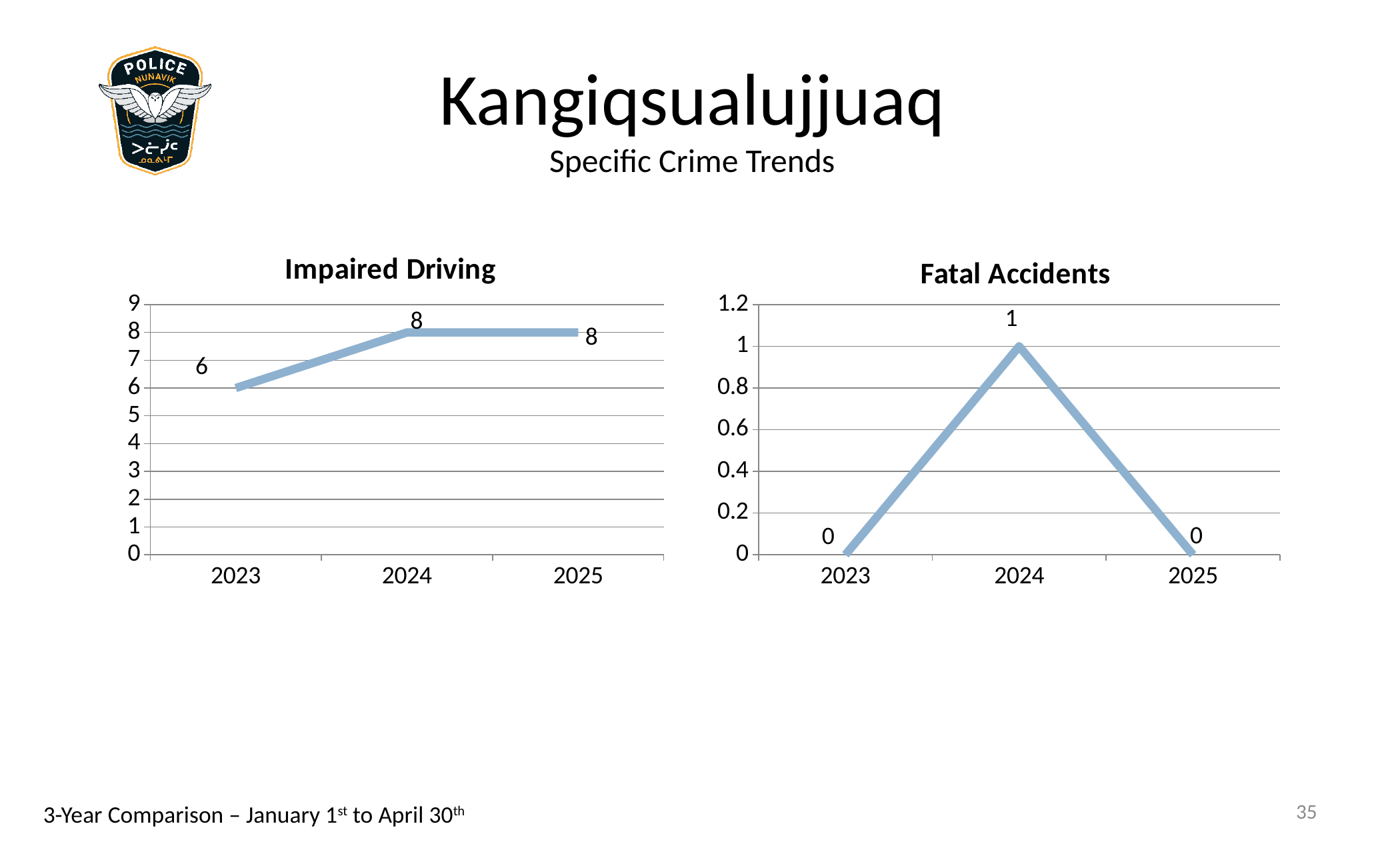
In the Impaired Driving chart, what is the value for 2025? 8 In the Impaired Driving chart, do the values rise or fall from 2023 to 2024? rise In the Fatal Accidents chart, what is the value for 2025? 0 In the Impaired Driving chart, which year has the lowest value? 2023 In the Impaired Driving chart, what is the value for 2023? 6 How many years are plotted in the Fatal Accidents chart? 3 In the Fatal Accidents chart, which year has the highest value? 2024 In the Impaired Driving chart, what is the difference between the 2024 value and the 2023 value? 2 In the Impaired Driving chart, is the value for 2024 larger or smaller than the value for 2023? larger What kind of chart is the Impaired Driving chart? line chart What is the title of the chart on the right side of the slide? Fatal Accidents In the Fatal Accidents chart, what is the value for 2024? 1